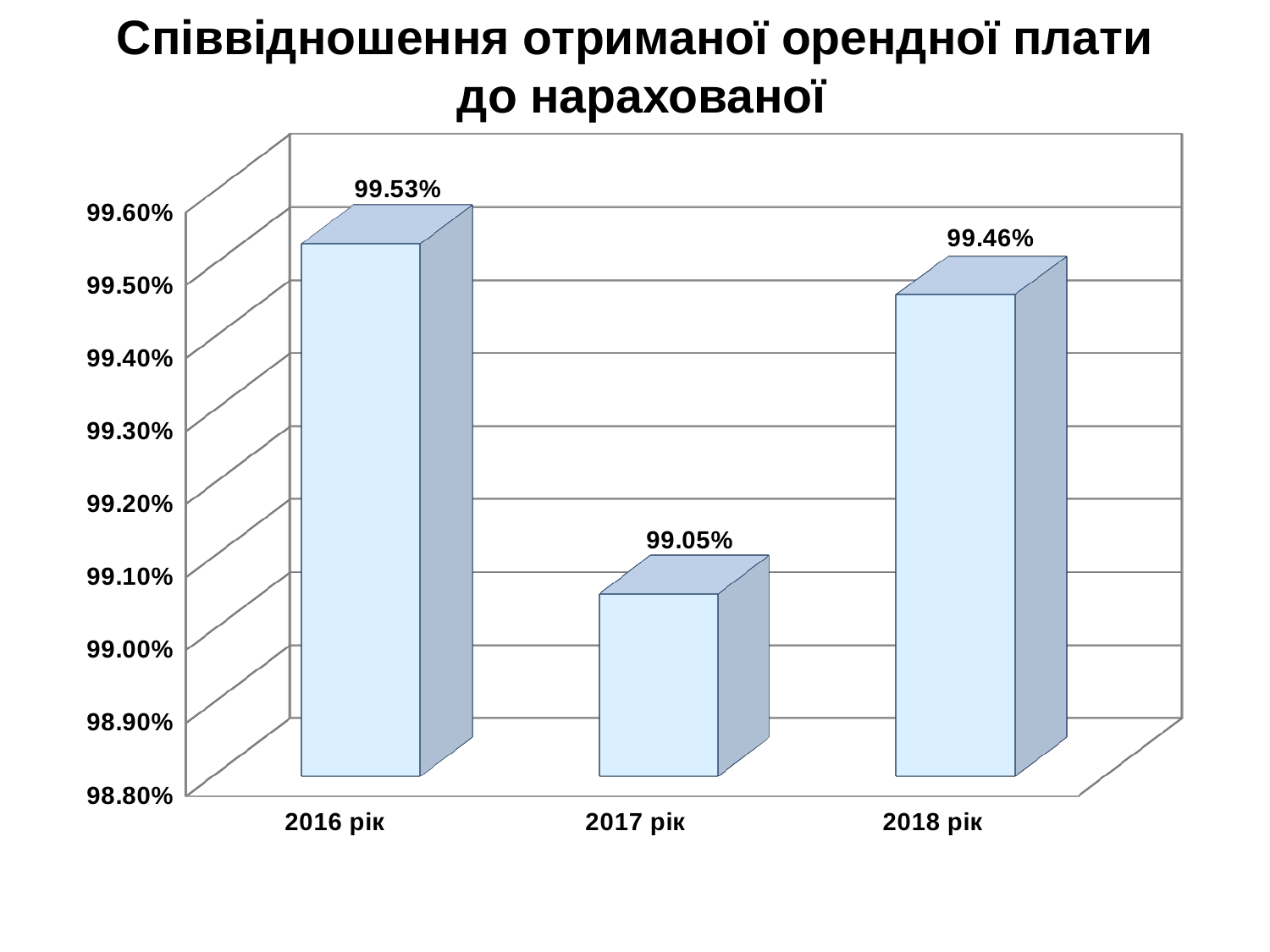
Which year has the lowest value? 2017 рік What is the value for 2018 рік? 99.46% What is the difference between the values for 2018 рік and 2017 рік? 0.41% What is the title of the chart? Співвідношення отриманої орендної плати до нарахованої What is the difference between the values for 2016 рік and 2017 рік? 0.48% What is the value for 2016 рік? 99.53% Which is larger, the value for 2016 рік or the value for 2018 рік? 2016 рік Is the value for 2017 рік greater or less than 99.20%? less What kind of chart is shown on the slide? bar chart What is the value for 2017 рік? 99.05% How many years are shown on the chart? 3 Which year has the highest value? 2016 рік